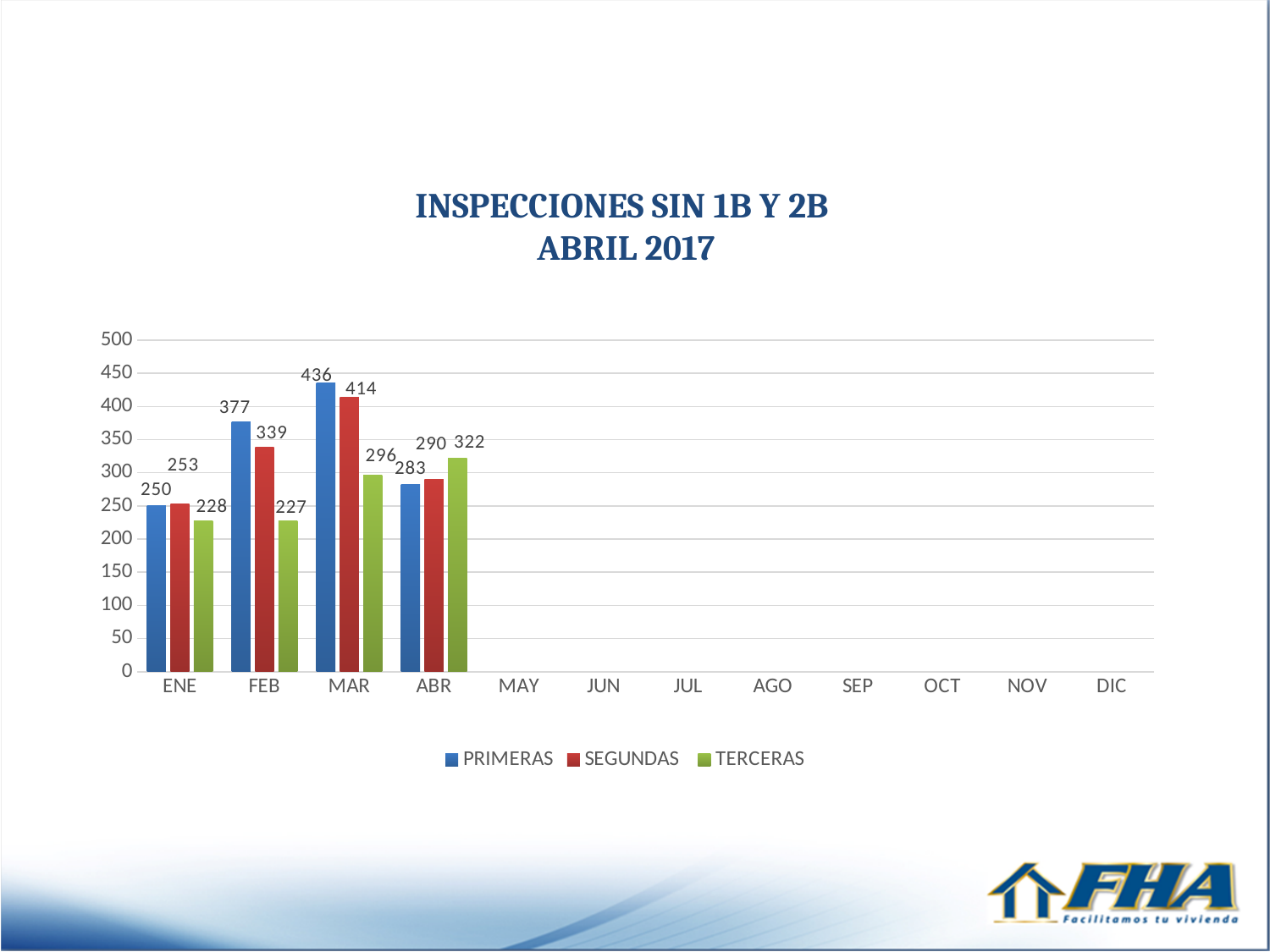
What type of chart is shown on the slide? Bar chart How many series does the legend list? 3 In which month is the PRIMERAS value highest? MAR Does the PRIMERAS value rise or fall from ENE to MAR? Rise What is the value for SEGUNDAS in FEB? 339 What is the difference between the PRIMERAS and SEGUNDAS values in MAR? 22 What is the value for PRIMERAS in MAR? 436 What is the title of the chart? INSPECCIONES SIN 1B Y 2B ABRIL 2017 Which is larger in ABR, PRIMERAS or TERCERAS? TERCERAS What is the value for TERCERAS in ABR? 322 In which month is the TERCERAS value lowest? FEB How many months have data plotted in the chart? 4